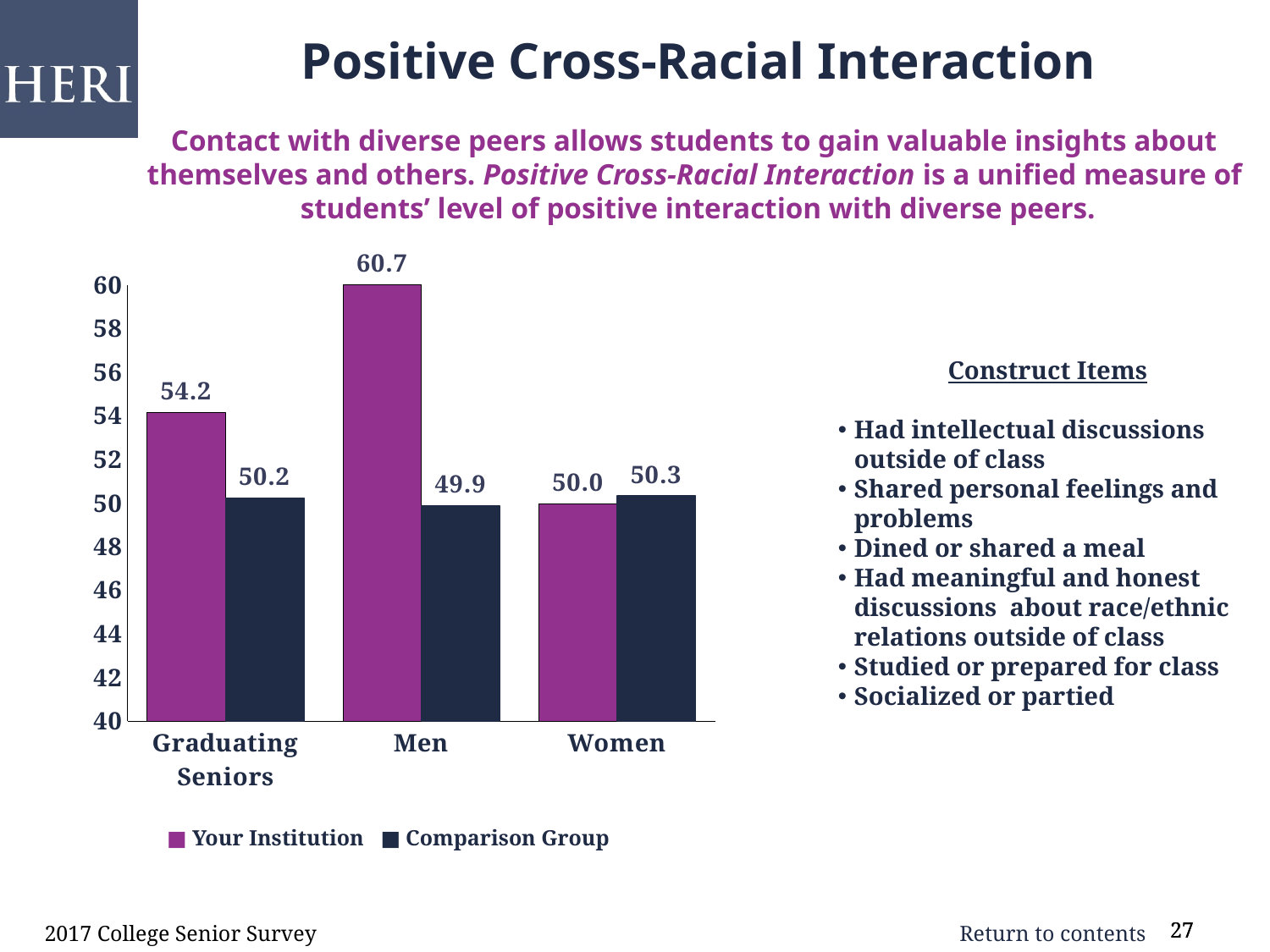
For Women, which is larger: Your Institution or the Comparison Group? Comparison Group What kind of chart is shown on the slide? Bar chart What is the value for Your Institution for Men? 60.7 What is the difference between Your Institution and the Comparison Group for Men? 10.8 How many categories are shown on the x axis? 3 What is the difference between Your Institution and the Comparison Group for Graduating Seniors? 4.0 What is the value for the Comparison Group for Graduating Seniors? 50.2 Is the value for Your Institution for Men greater or less than 56? greater What is the value for Your Institution for Women? 50.0 Which category has the lowest value for the Comparison Group? Men Which category has the highest value for Your Institution? Men How many series does the legend list? 2